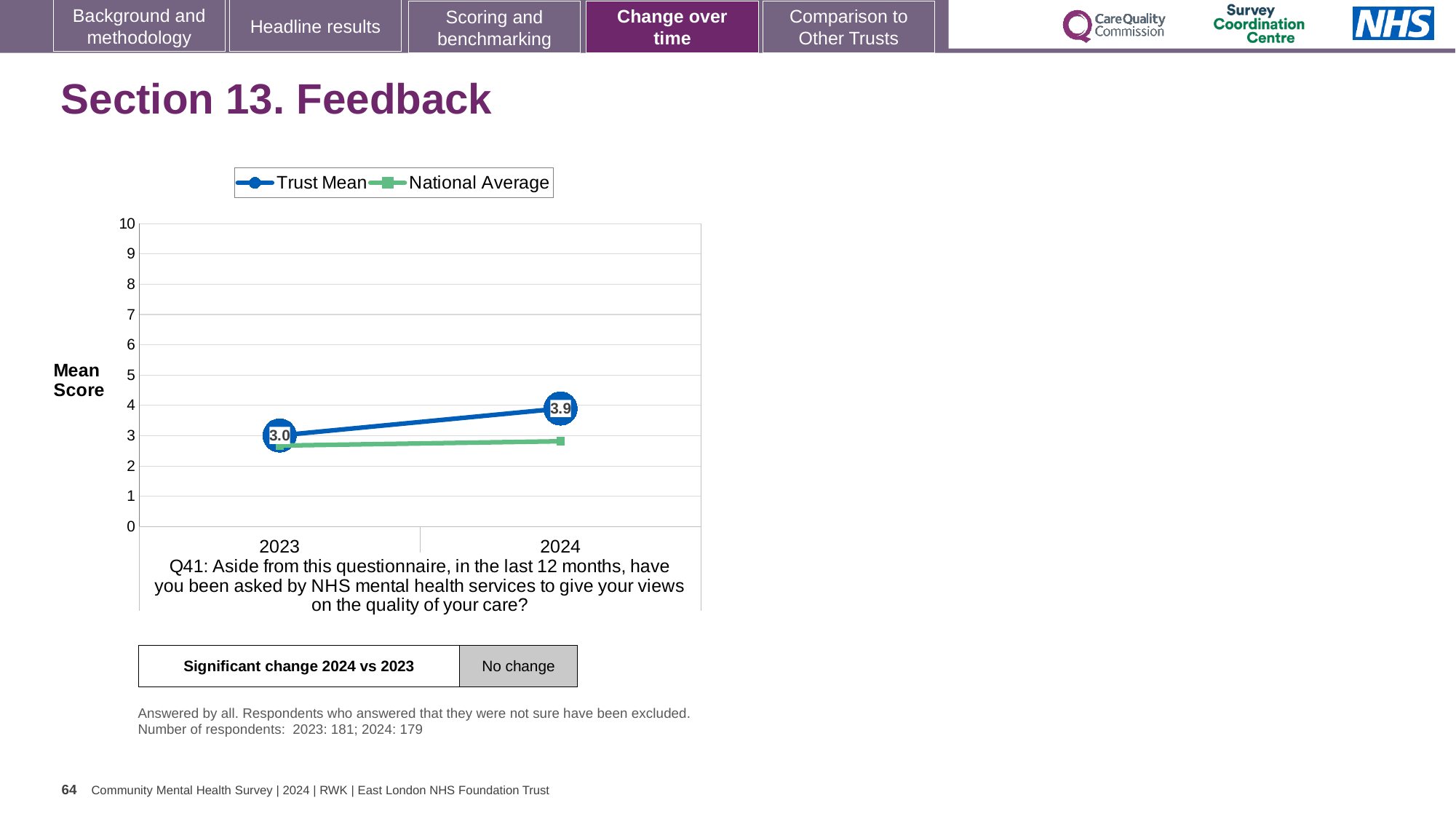
In which year is the Trust Mean score lowest? 2023 Does the Trust Mean score rise or fall from 2023 to 2024? rise How many series does the chart legend list? 2 What kind of chart is shown on the slide? line chart How many years are shown on the x axis of the chart? 2 What is the difference between the Trust Mean score in 2024 and in 2023? 0.9 Is the National Average value for 2023 greater or less than 3? less Is the National Average value for 2024 greater or less than 2? greater What is the Trust Mean score for 2024? 3.9 What is the Trust Mean score for 2023? 3.0 In 2024, which is larger: the Trust Mean or the National Average? Trust Mean In which year is the Trust Mean score highest? 2024